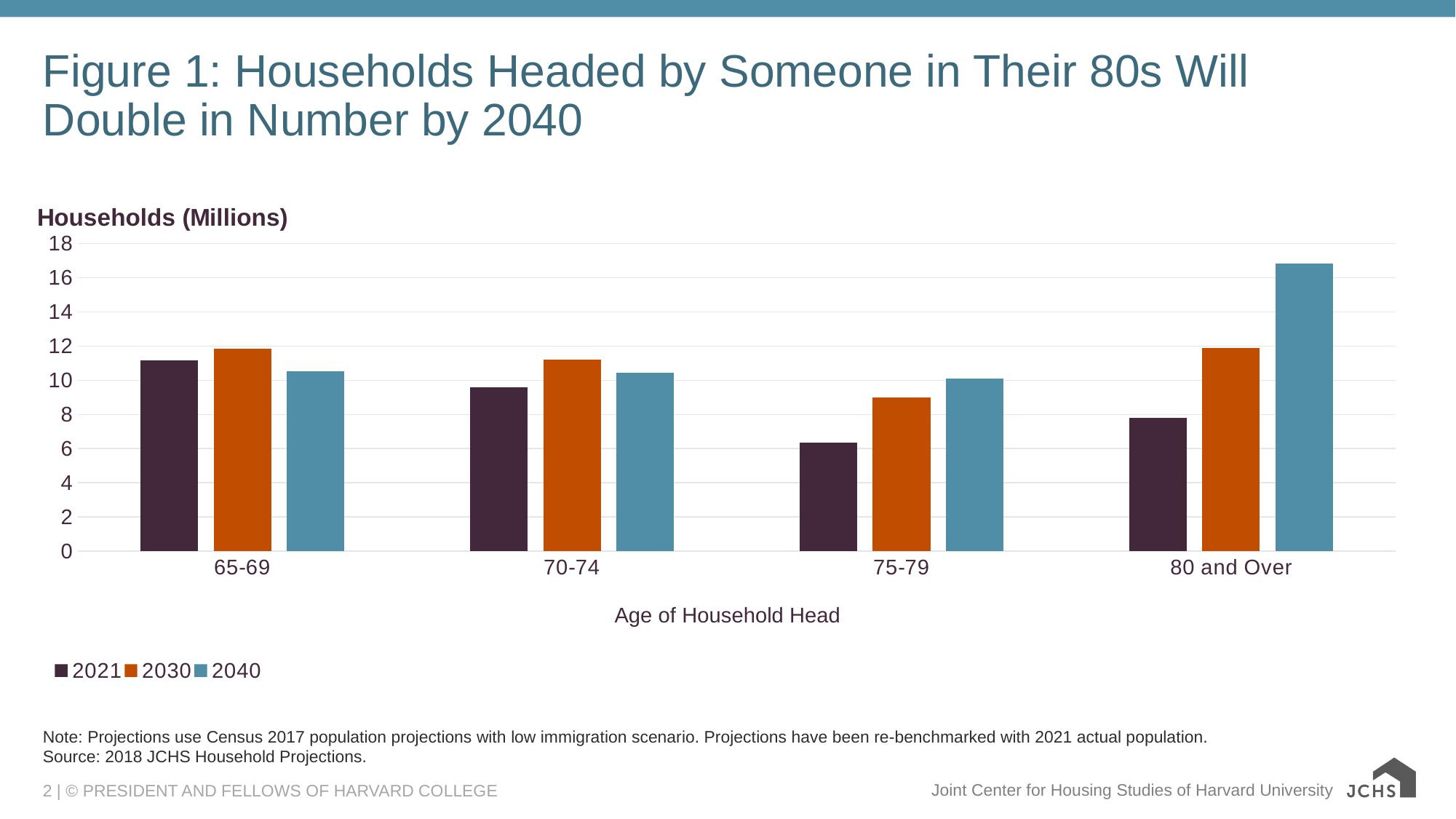
Which age group has the lowest value for 2021? 75-79 Which age group has the highest value for 2040? 80 and Over What is the title of the x axis? Age of Household Head Is the 2021 value for 75-79 greater or less than 8? less How many age groups are shown on the x axis? 4 Is the 2040 value for 80 and Over greater or less than 14? greater For the 80 and Over group, which year has the highest value? 2040 Which is larger for 2021: the value for 65-69 or the value for 70-74? 65-69 What kind of chart is shown on the slide? bar chart How many series does the legend list? 3 For the 80 and Over group, do the values rise or fall from 2021 to 2040? rise Is the 2030 value for 70-74 greater or less than 10? greater